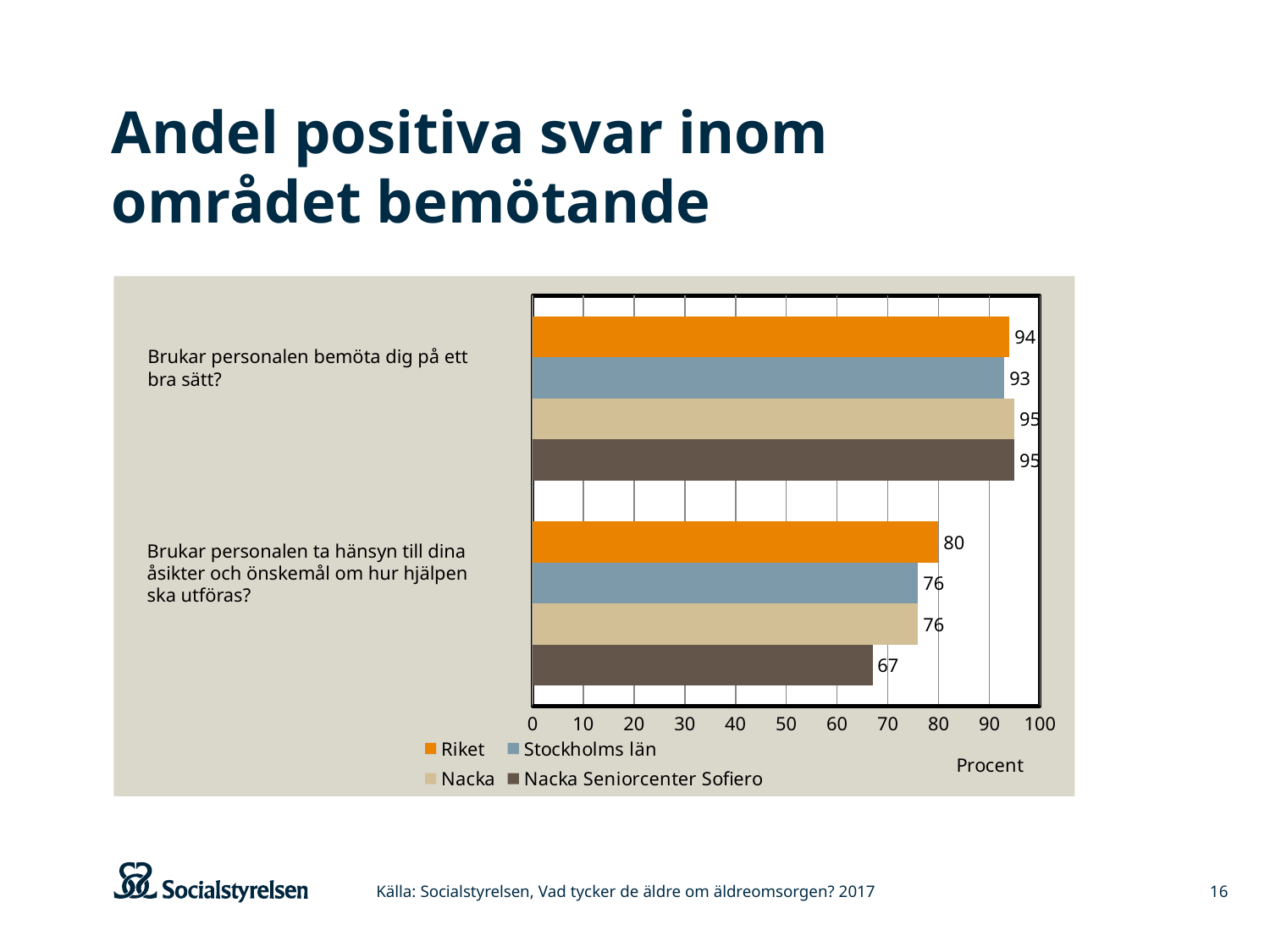
Which series has the highest value on "Brukar personalen ta hänsyn till dina åsikter och önskemål om hur hjälpen ska utföras?"? Riket What is the value for Nacka on "Brukar personalen ta hänsyn till dina åsikter och önskemål om hur hjälpen ska utföras?"? 76 What is the label on the horizontal axis of the chart? Procent What kind of chart is shown on the slide? Bar chart What is the value for Riket on "Brukar personalen bemöta dig på ett bra sätt?"? 94 Which is larger for Nacka Seniorcenter Sofiero: the value on "Brukar personalen bemöta dig på ett bra sätt?" or on "Brukar personalen ta hänsyn till dina åsikter och önskemål om hur hjälpen ska utföras?"? Brukar personalen bemöta dig på ett bra sätt? Which series has the lowest value on "Brukar personalen ta hänsyn till dina åsikter och önskemål om hur hjälpen ska utföras?"? Nacka Seniorcenter Sofiero Is the value for Nacka Seniorcenter Sofiero on "Brukar personalen ta hänsyn till dina åsikter och önskemål om hur hjälpen ska utföras?" greater or less than 70? less What is the difference between the Riket value and the Nacka Seniorcenter Sofiero value on "Brukar personalen ta hänsyn till dina åsikter och önskemål om hur hjälpen ska utföras?"? 13 What is the value for Nacka Seniorcenter Sofiero on "Brukar personalen ta hänsyn till dina åsikter och önskemål om hur hjälpen ska utföras?"? 67 How many series does the legend list? 4 What is the value for Stockholms län on "Brukar personalen bemöta dig på ett bra sätt?"? 93